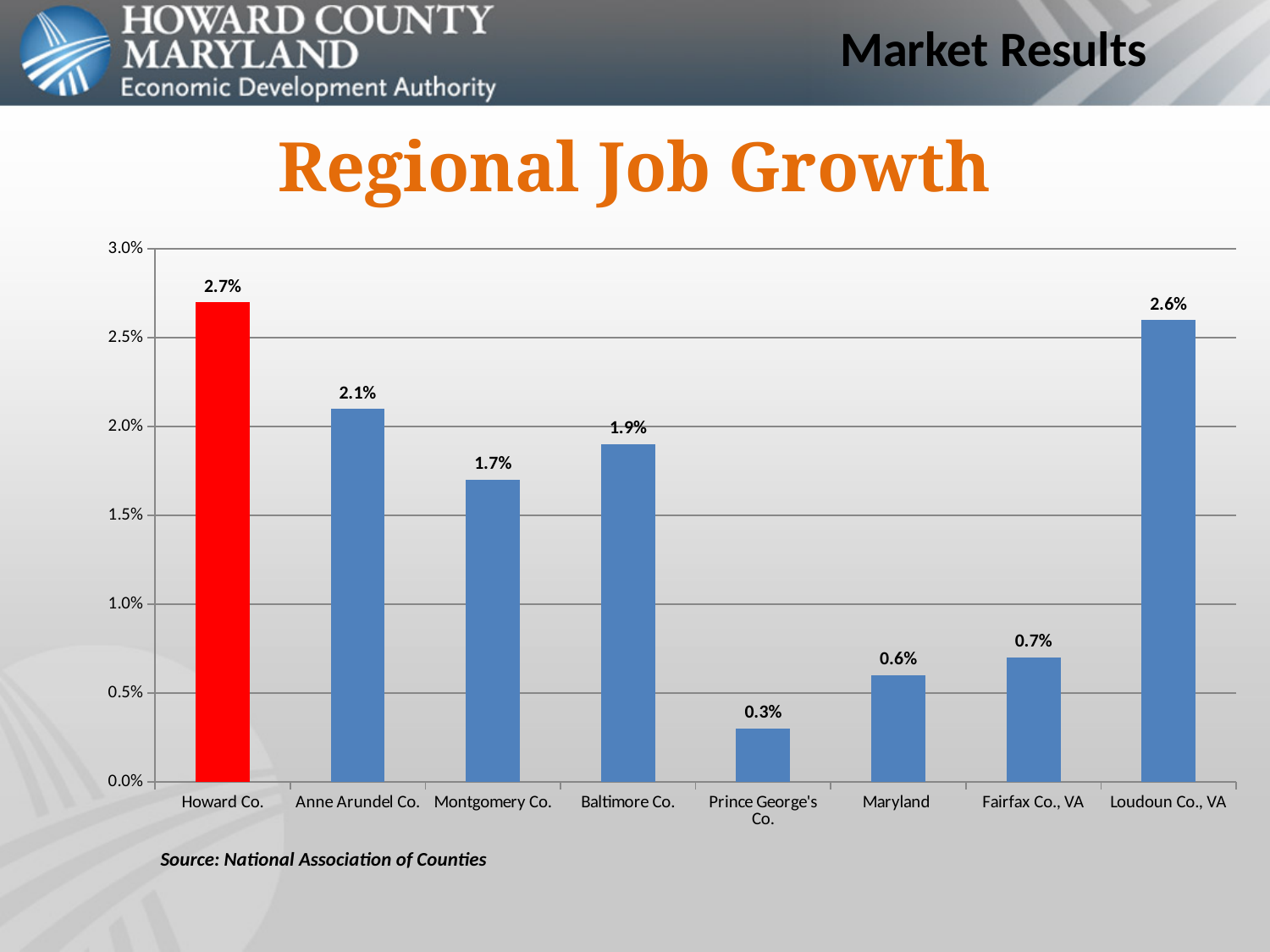
How many categories are shown on the chart? 8 What is the job growth value for Prince George's Co.? 0.3% Which bar is coloured red? Howard Co. Which has higher job growth, Baltimore Co. or Fairfax Co., VA? Baltimore Co. What is the title of the chart? Regional Job Growth What is the job growth value for Loudoun Co., VA? 2.6% What is the difference between the job growth of Anne Arundel Co. and Montgomery Co.? 0.4% Which category has the lowest job growth? Prince George's Co. What is the job growth value for Howard Co.? 2.7% What kind of chart is shown on the slide? bar chart Is the value for Maryland greater or less than 1.0%? less Which category has the highest job growth? Howard Co.